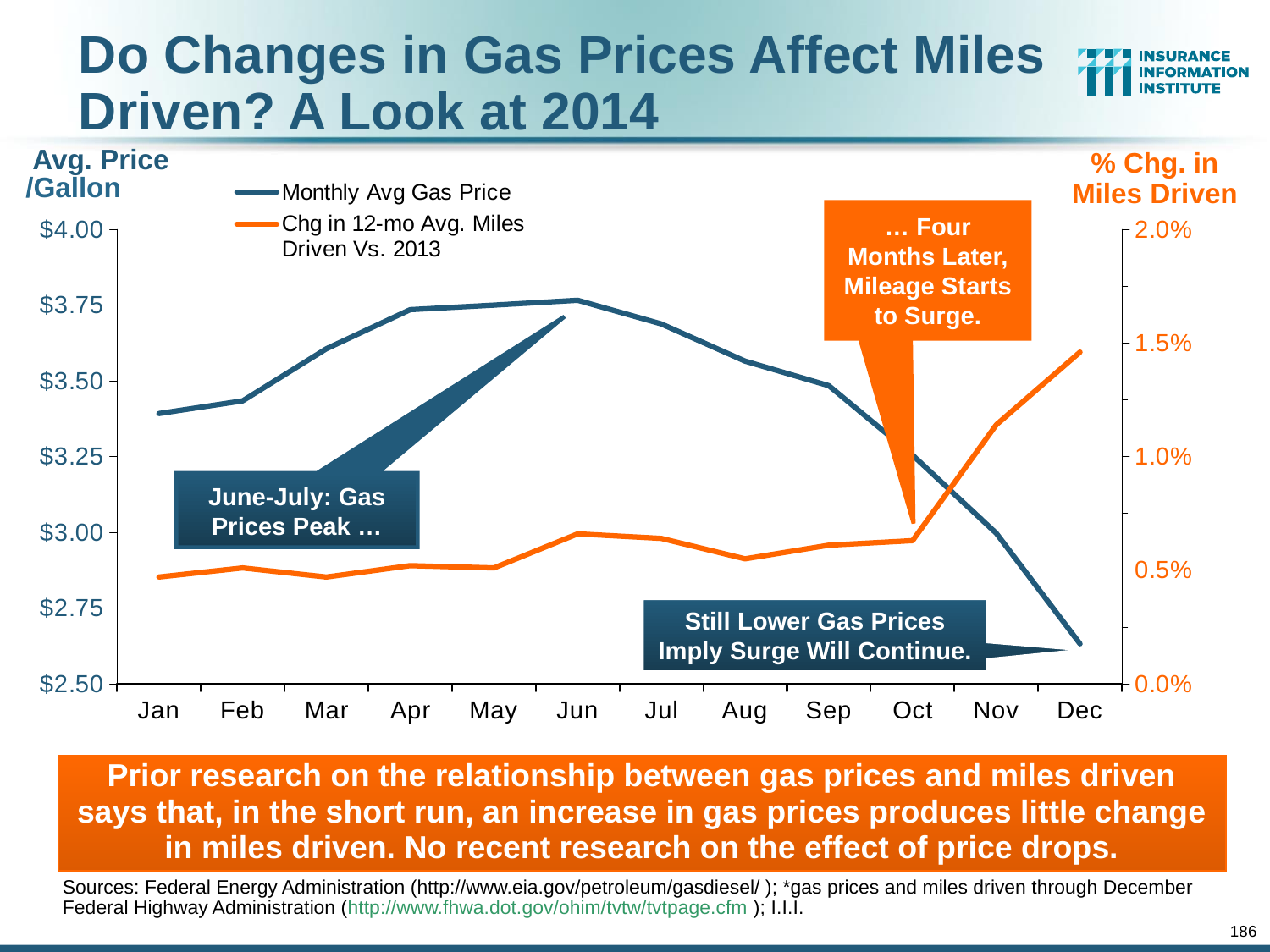
How many series does the legend list? 2 Is the Monthly Avg Gas Price for Dec greater or less than $2.75? less In which month is the Chg in 12-mo Avg. Miles Driven Vs. 2013 highest? Dec Does the Monthly Avg Gas Price rise or fall from Jun to Dec? fall What kind of chart is shown on the slide? line chart How many months are plotted along the x axis? 12 In which month is the Monthly Avg Gas Price highest? Jun Is the Monthly Avg Gas Price for Jan greater or less than $3.50? less Which is larger, the Monthly Avg Gas Price in Jan or in Dec? Jan Is the Chg in 12-mo Avg. Miles Driven Vs. 2013 for Dec greater or less than 1.0%? greater What is the title of the left vertical axis? Avg. Price /Gallon In which month is the Monthly Avg Gas Price lowest? Dec